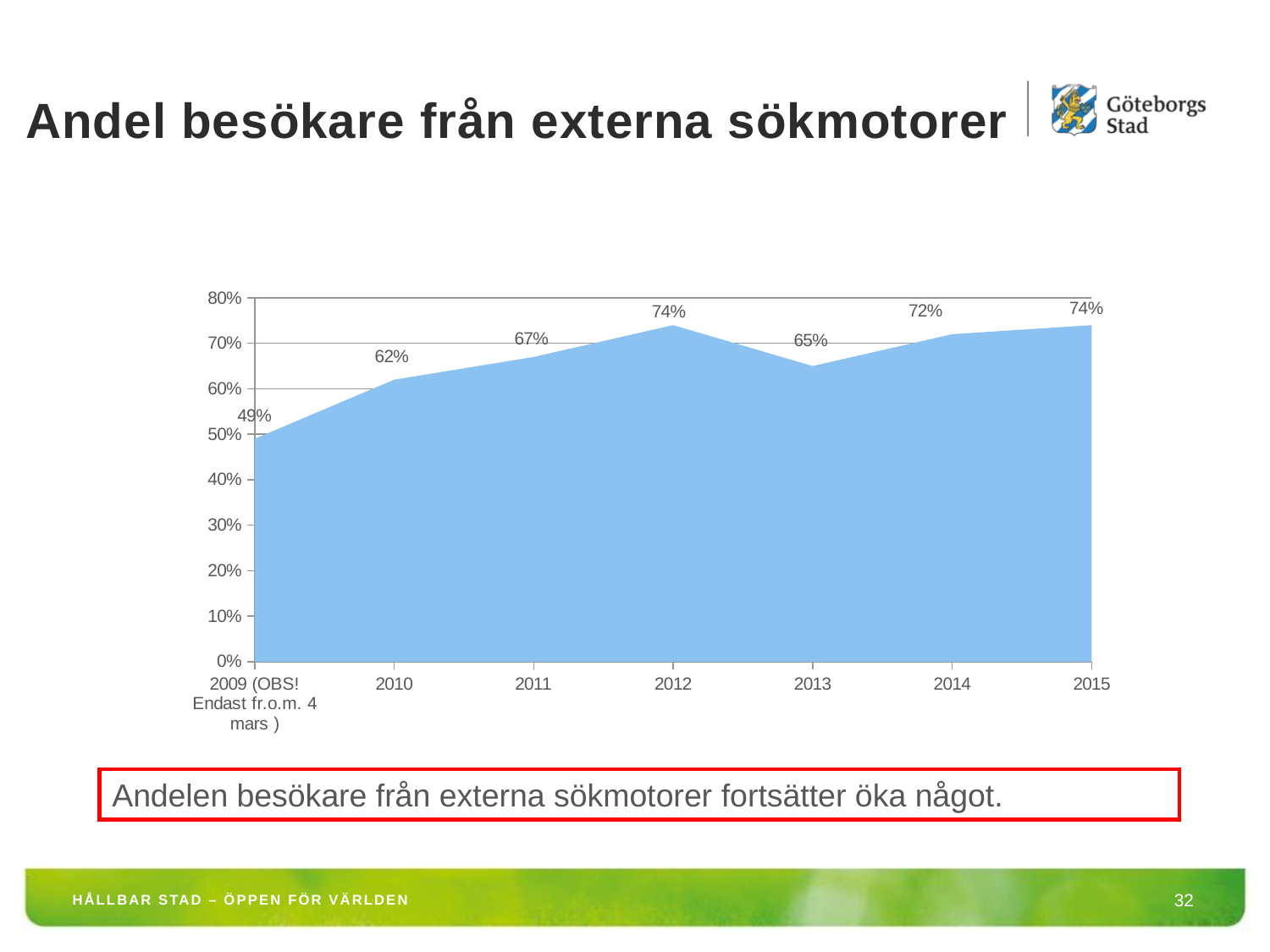
What is the value for 2013? 65% What is the difference between the values for 2015 and 2009? 25% What is the value for 2011? 67% What is the value for 2010? 62% What is the value for 2015? 74% What is the title of the slide containing the chart? Andel besökare från externa sökmotorer Which is larger, the value for 2014 or the value for 2013? 2014 Is the value for 2009 greater or less than 60%? less What is the difference between the values for 2012 and 2013? 9% What kind of chart is shown on the slide? area chart Which year has the lowest value? 2009 How many years are plotted on the chart? 7